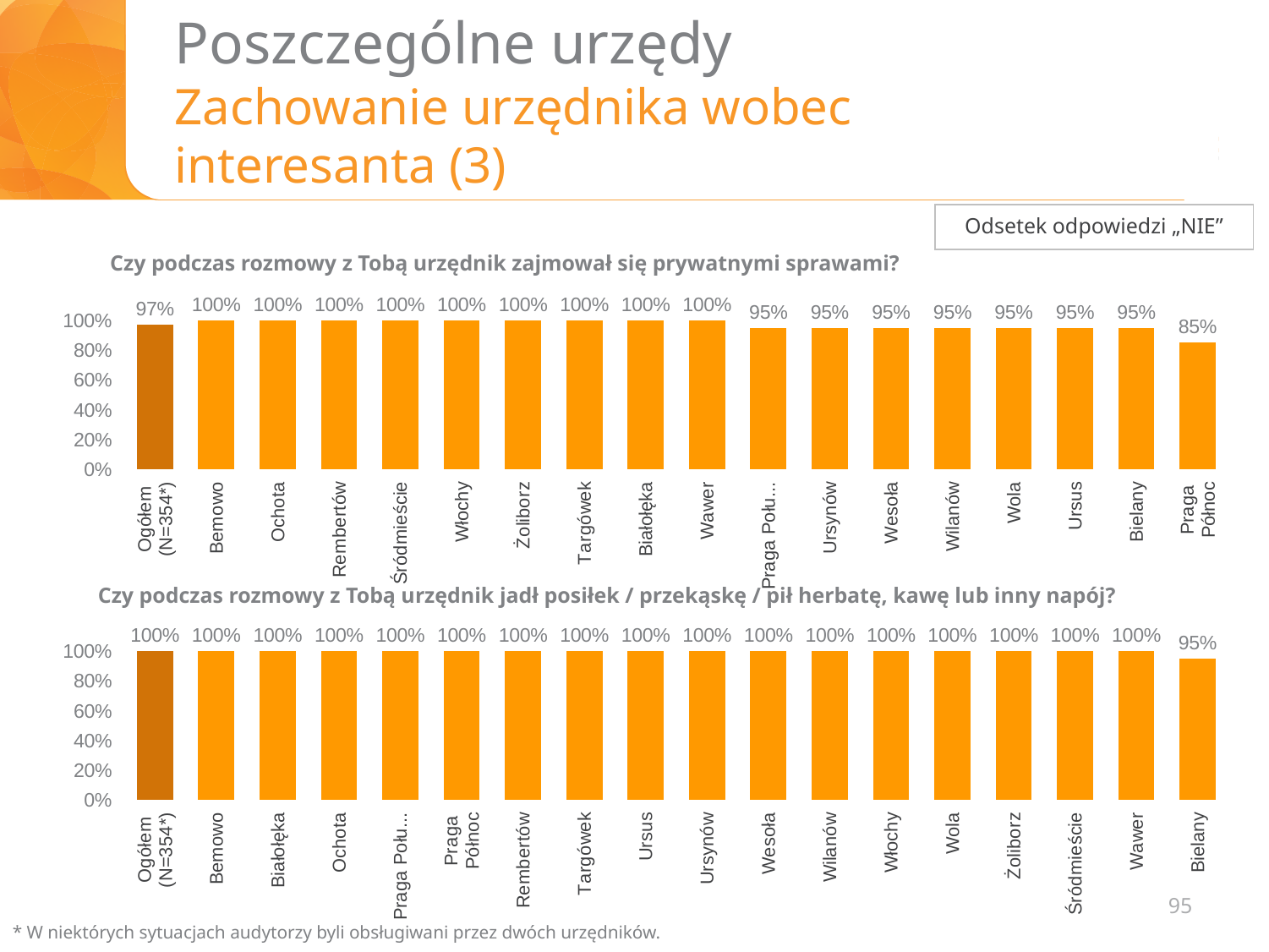
In the top chart ("Czy podczas rozmowy z Tobą urzędnik zajmował się prywatnymi sprawami?"), how many categories are shown on the x axis? 18 In the top chart ("Czy podczas rozmowy z Tobą urzędnik zajmował się prywatnymi sprawami?"), what is the difference between the values for Bemowo and Praga Północ? 15 percentage points In the top chart ("Czy podczas rozmowy z Tobą urzędnik zajmował się prywatnymi sprawami?"), what is the value for Praga Północ? 85% What kind of chart is the bottom chart on the slide? Bar chart In the top chart ("Czy podczas rozmowy z Tobą urzędnik zajmował się prywatnymi sprawami?"), what is the value for Wola? 95% In the top chart ("Czy podczas rozmowy z Tobą urzędnik zajmował się prywatnymi sprawami?"), which is larger, the value for Wawer or the value for Ursynów? Wawer According to the box in the top right of the slide, what do the percentages in the charts represent? Odsetek odpowiedzi „NIE” In the bottom chart ("Czy podczas rozmowy z Tobą urzędnik jadł posiłek / przekąskę / pił herbatę, kawę lub inny napój?"), what is the value for Bielany? 95% In the bottom chart ("Czy podczas rozmowy z Tobą urzędnik jadł posiłek / przekąskę / pił herbatę, kawę lub inny napój?"), which category has the lowest value? Bielany In the top chart ("Czy podczas rozmowy z Tobą urzędnik zajmował się prywatnymi sprawami?"), what is the value for Ogółem (N=354*)? 97% In the bottom chart ("Czy podczas rozmowy z Tobą urzędnik jadł posiłek / przekąskę / pił herbatę, kawę lub inny napój?"), what is the value for Wawer? 100% In the top chart ("Czy podczas rozmowy z Tobą urzędnik zajmował się prywatnymi sprawami?"), which category has the lowest value? Praga Północ